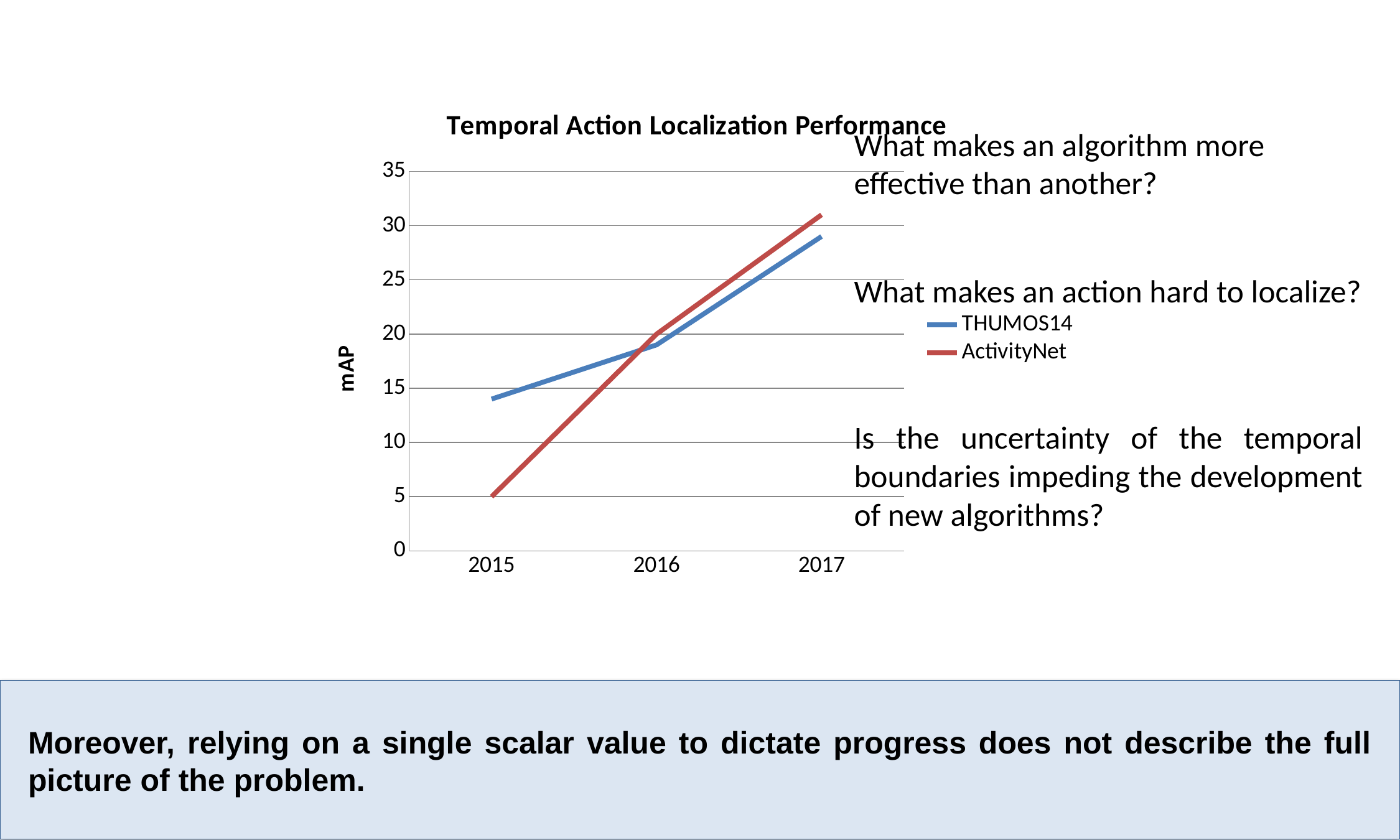
Is the ActivityNet value for 2015 greater or less than 10? less Does the THUMOS14 line rise or fall from 2015 to 2017? rise What kind of chart is shown on the slide? line chart How many years are shown on the x axis of the chart? 3 Is the THUMOS14 value for 2015 greater or less than 20? less In 2017, which series has the higher mAP, THUMOS14 or ActivityNet? ActivityNet Does the ActivityNet line rise or fall from 2015 to 2017? rise What is the label of the y axis? mAP What is the title of the chart? Temporal Action Localization Performance Is the THUMOS14 value for 2017 greater or less than 25? greater In 2015, which series has the higher mAP, THUMOS14 or ActivityNet? THUMOS14 How many series does the chart's legend list? 2